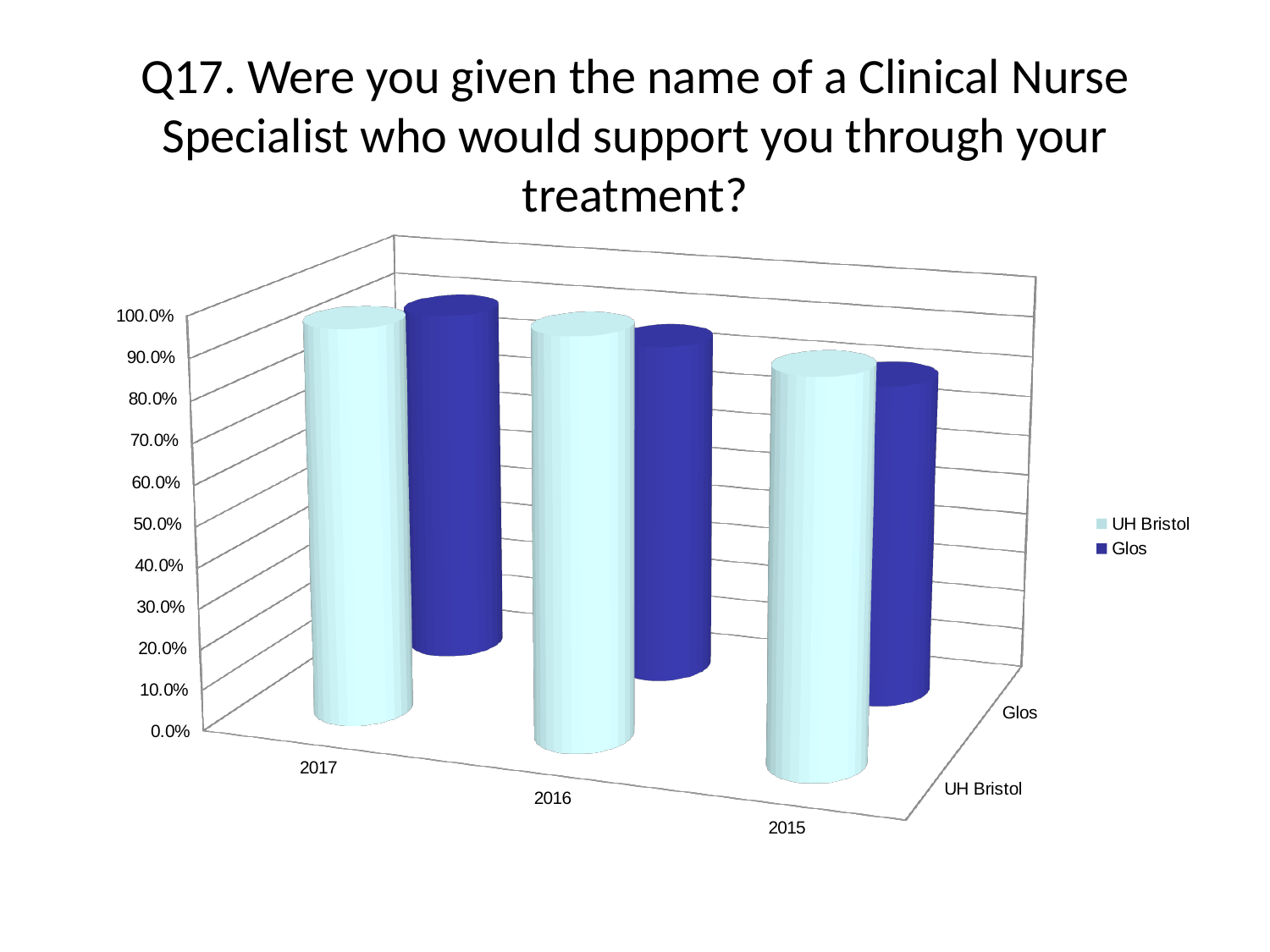
What is the title of the chart on the slide? Q17. Were you given the name of a Clinical Nurse Specialist who would support you through your treatment? How many year categories are shown on the x axis of the chart? 3 What kind of chart is shown on the slide? bar chart Which two series are listed in the chart's legend? UH Bristol and Glos Is the value for UH Bristol in 2017 greater or less than 50.0%? greater How many series does the chart's legend list? 2 Is the value for Glos in 2015 greater or less than 50.0%? greater Is the value for Glos in 2016 greater or less than 40.0%? greater What is the highest value shown on the chart's vertical axis? 100.0%